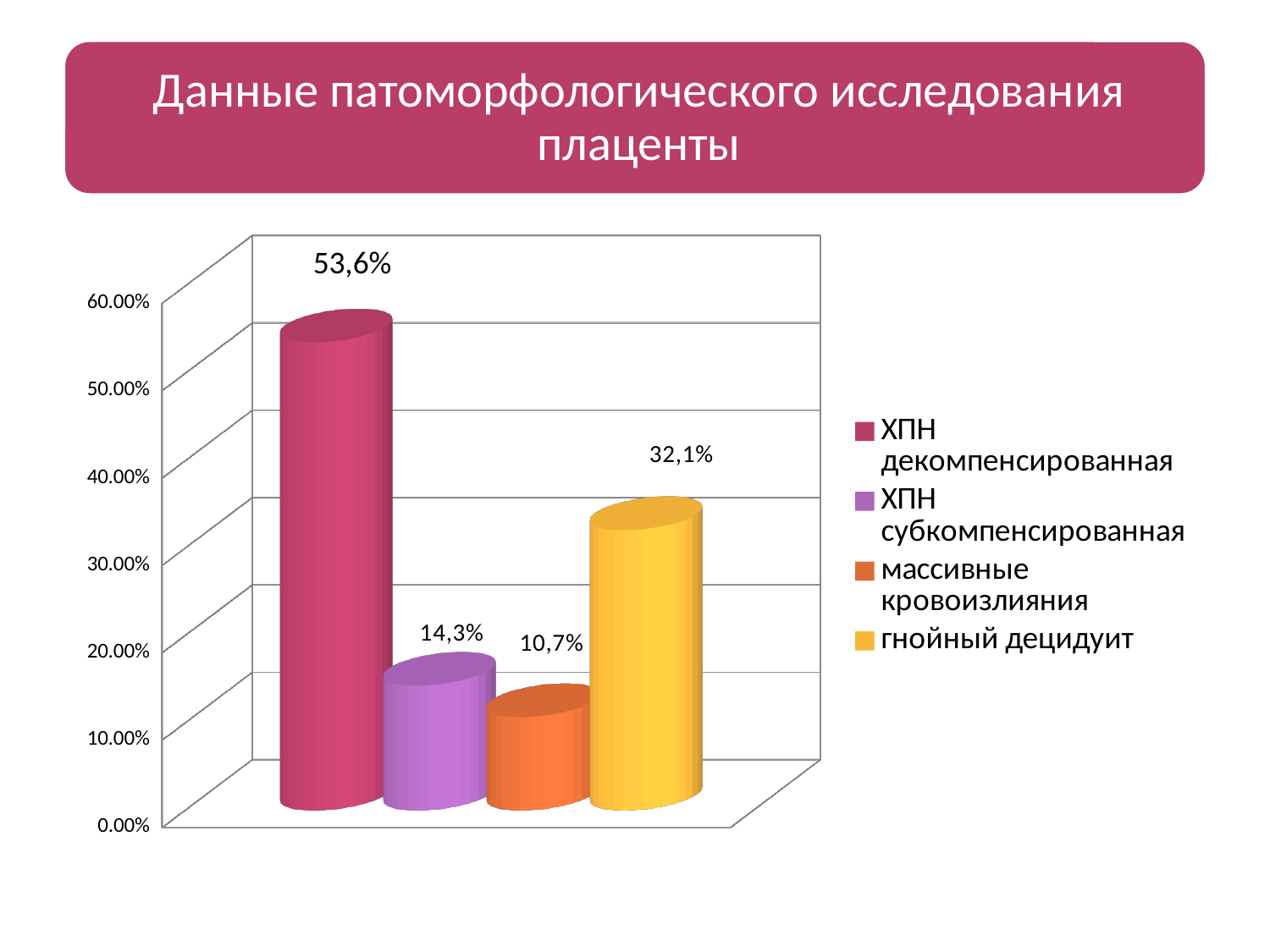
What value is shown for ХПН декомпенсированная? 53,6% What value is shown for массивные кровоизлияния? 10,7% What value is shown for ХПН субкомпенсированная? 14,3% What type of chart is shown on the slide? bar chart Which is larger, the value for ХПН субкомпенсированная or the value for гнойный децидуит? гнойный децидуит What is the difference between the values for ХПН декомпенсированная and гнойный децидуит? 21,5% What value is shown for гнойный децидуит? 32,1% Which category has the highest value? ХПН декомпенсированная Which category has the lowest value? массивные кровоизлияния How many entries does the legend list? 4 How many bars are plotted in the chart? 4 Is the value for гнойный децидуит greater or less than 40.00%? less